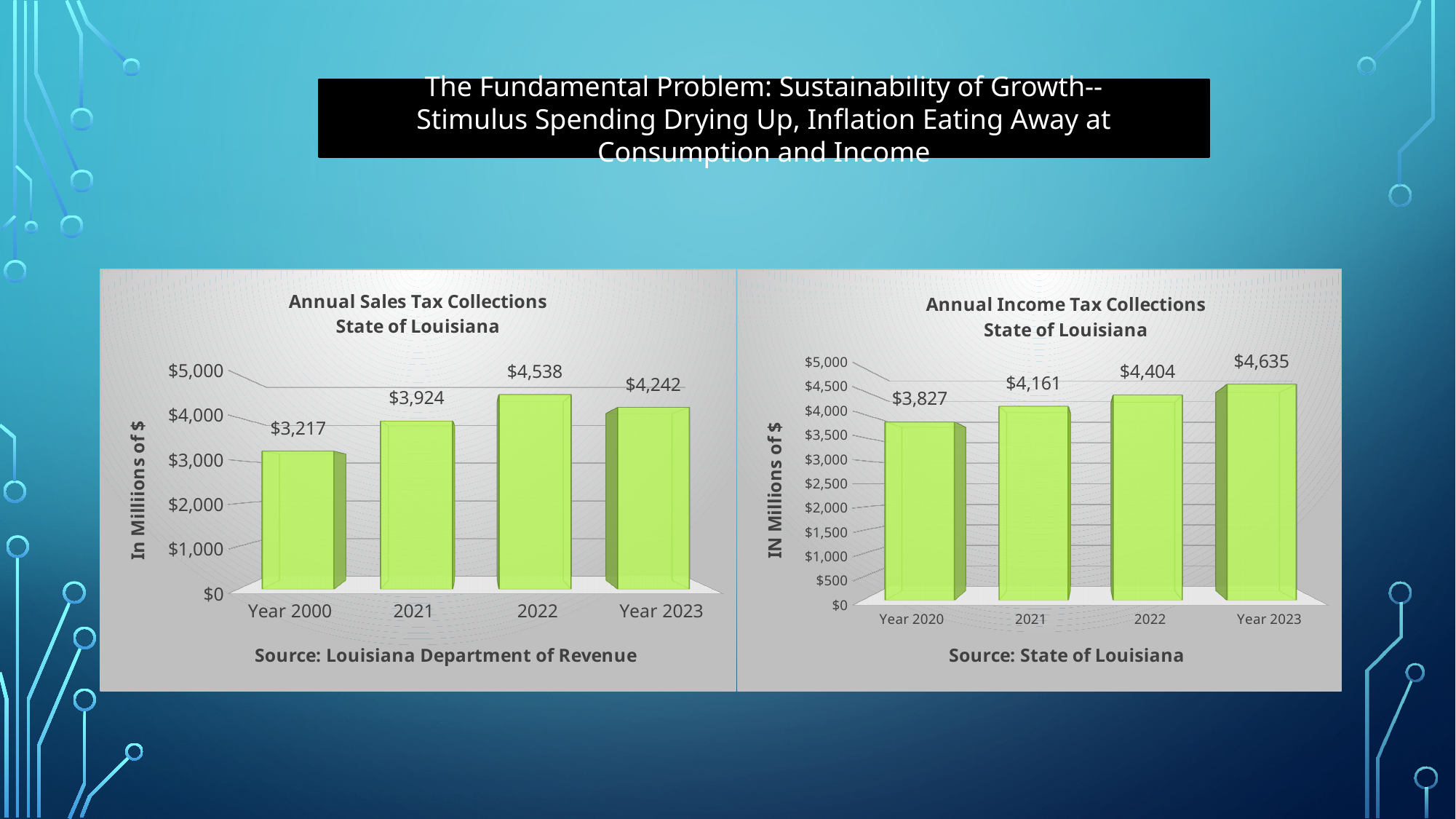
In the Annual Income Tax Collections chart, what is the value for Year 2020? $3,827 In the Annual Sales Tax Collections chart, what is the value for 2022? $4,538 In the Annual Income Tax Collections chart, is the value for 2021 greater or less than $4,000? greater In the Annual Income Tax Collections chart, which category has the lowest value? Year 2020 What source is cited below the Annual Sales Tax Collections chart? Louisiana Department of Revenue What kind of chart is the Annual Income Tax Collections chart? bar chart How many categories are shown in the Annual Sales Tax Collections chart? 4 In the Annual Income Tax Collections chart, what is the difference between the Year 2023 value and the Year 2020 value? $808 In the Annual Sales Tax Collections chart, which is larger: the value for 2021 or the value for Year 2023? Year 2023 In the Annual Income Tax Collections chart, do the values rise or fall from Year 2020 to Year 2023? rise In the Annual Sales Tax Collections chart, which category has the highest value? 2022 In the Annual Sales Tax Collections chart, what is the difference between the 2022 value and the Year 2023 value? $296